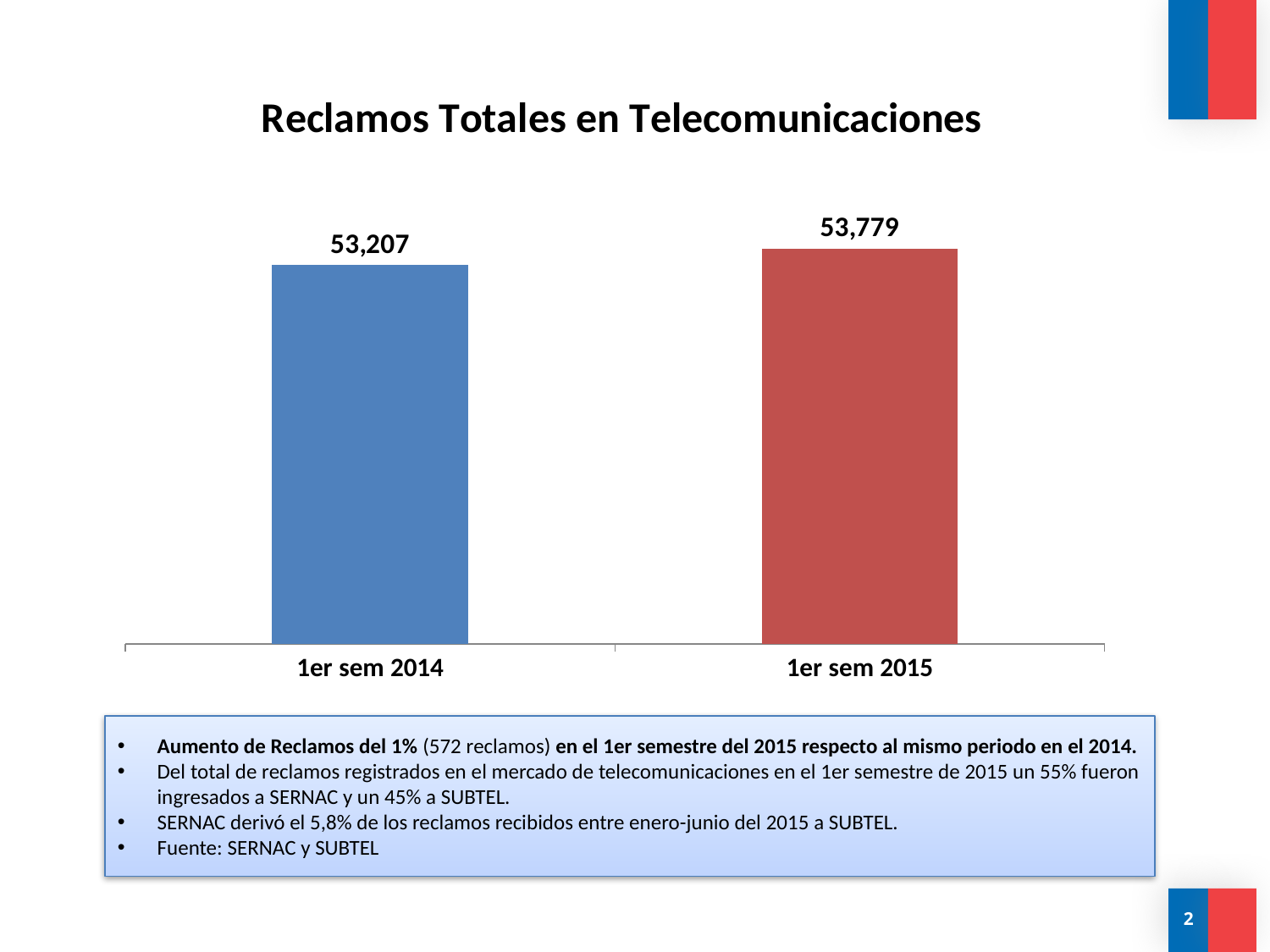
What kind of chart is shown on the slide? bar chart What is the value for 1er sem 2014? 53,207 What colour is the bar for 1er sem 2015? red Which is larger, the value for 1er sem 2014 or 1er sem 2015? 1er sem 2015 Do the values rise or fall from 1er sem 2014 to 1er sem 2015? rise How many categories are shown on the x axis? 2 What is the difference between the values for 1er sem 2015 and 1er sem 2014? 572 Which category has the highest value? 1er sem 2015 What is the title of the chart? Reclamos Totales en Telecomunicaciones Which category has the lowest value? 1er sem 2014 What is the value for 1er sem 2015? 53,779